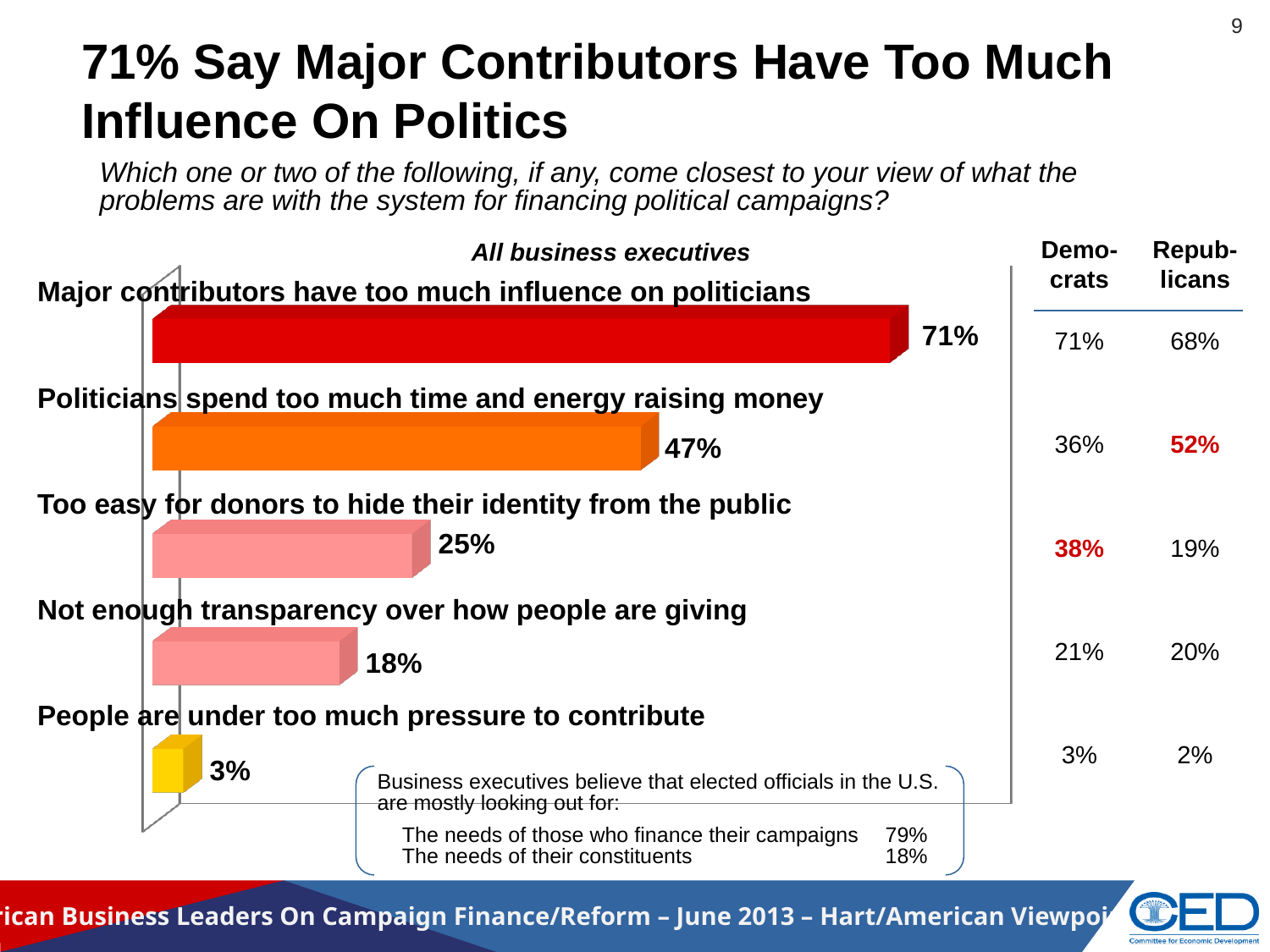
What percentage of all business executives say it is too easy for donors to hide their identity from the public? 25% What colour is the bar for 'Politicians spend too much time and energy raising money'? Orange What percentage of all business executives say people are under too much pressure to contribute? 3% Which problem has the lowest percentage among all business executives? People are under too much pressure to contribute What percentage of all business executives say politicians spend too much time and energy raising money? 47% Among all business executives, which is larger: 'Too easy for donors to hide their identity from the public' or 'Not enough transparency over how people are giving'? Too easy for donors to hide their identity from the public Which problem has the highest percentage among all business executives? Major contributors have too much influence on politicians What is the difference between the percentages for 'Major contributors have too much influence on politicians' and 'Politicians spend too much time and energy raising money' among all business executives? 24% What kind of chart is used to show the responses of all business executives? Bar chart Do the bar values rise or fall going from the top category to the bottom category? Fall What percentage of all business executives say major contributors have too much influence on politicians? 71% How many problem categories are shown in the bar chart? 5